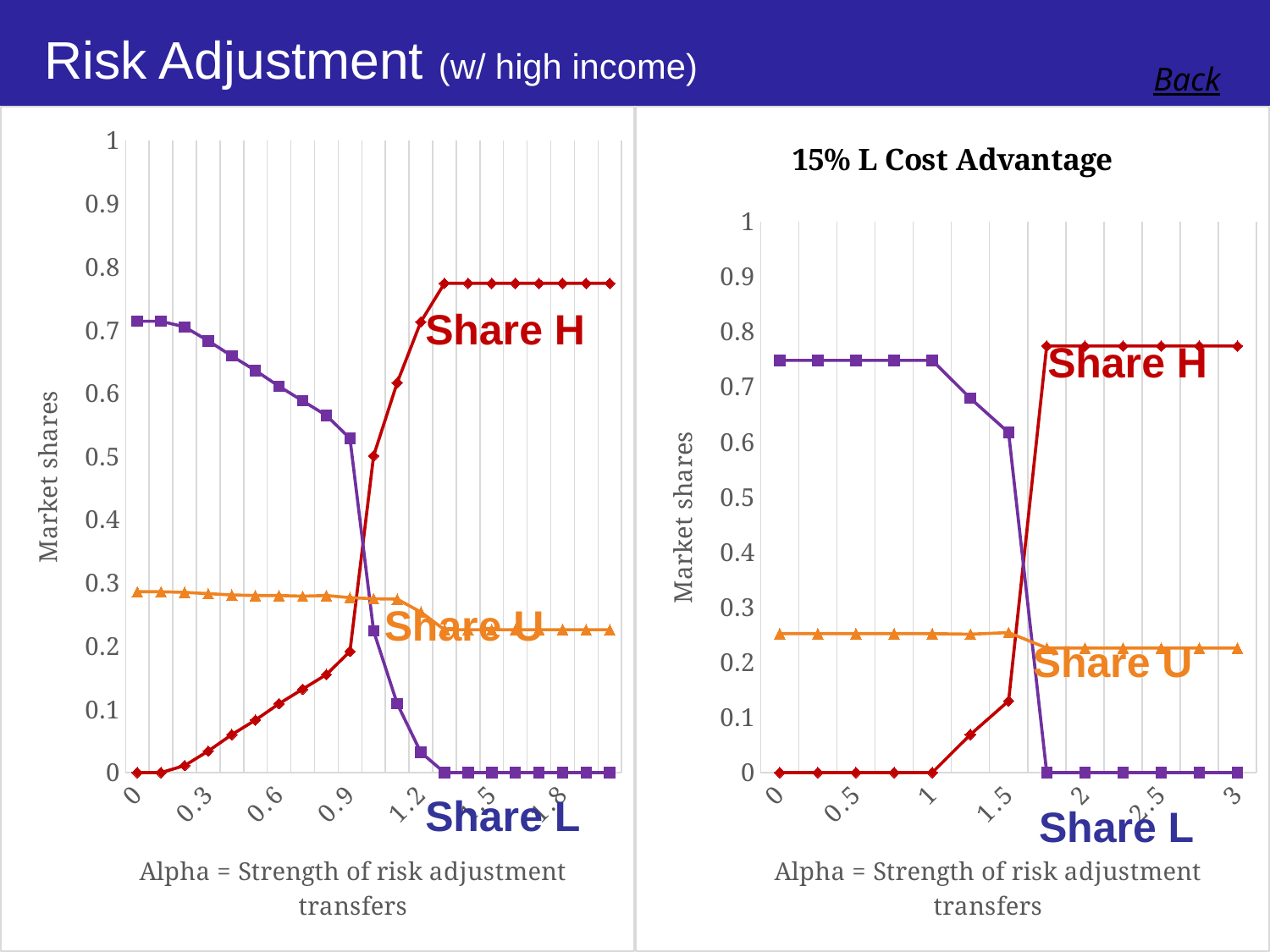
In the right chart, is the value of Share H at alpha 3 greater or less than 0.7? greater In the right chart, what is the value of Share L at alpha 3? 0 In the left chart, does Share H rise or fall as alpha increases? rises In the left chart, what is the value of Share H at alpha 0? 0 What is the title of the right chart? 15% L Cost Advantage In the right chart, does Share L rise or fall as alpha increases? falls What kind of chart is the left chart on the slide? line chart In the left chart, which series is higher at alpha 0: Share L or Share U? Share L What is the x-axis label of the right chart? Alpha = Strength of risk adjustment transfers In the right chart, is the value of Share U at alpha 0 greater or less than 0.3? less In the left chart, is the value of Share L at alpha 0 greater or less than 0.6? greater In the right chart, which series is higher at alpha 3: Share H or Share U? Share H